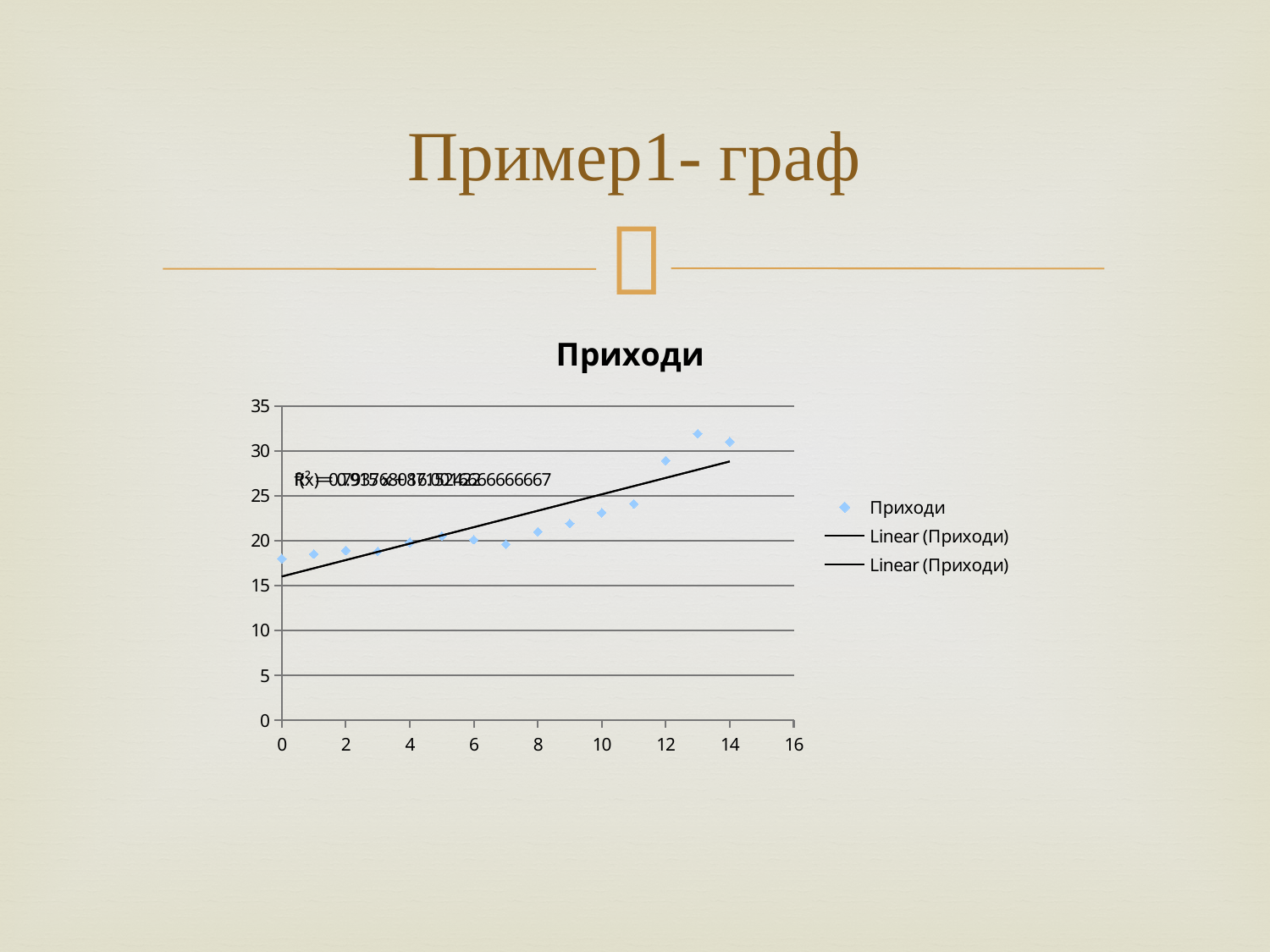
How many entries does the chart legend list? 3 What is the highest value shown on the vertical axis? 35 Is the Приходи value at x = 12 greater or less than 25? greater Is the Приходи value at x = 0 greater or less than 20? less Is the Приходи value at x = 10 greater or less than 25? less Do the Приходи values generally rise or fall as x increases from 0 to 14? rise What kind of chart is shown on the slide? scatter chart Which has the larger Приходи value, x = 8 or x = 12? x = 12 What is the title of the chart? Приходи Which has the larger Приходи value, x = 4 or x = 13? x = 13 How many data points are plotted for the Приходи series? 15